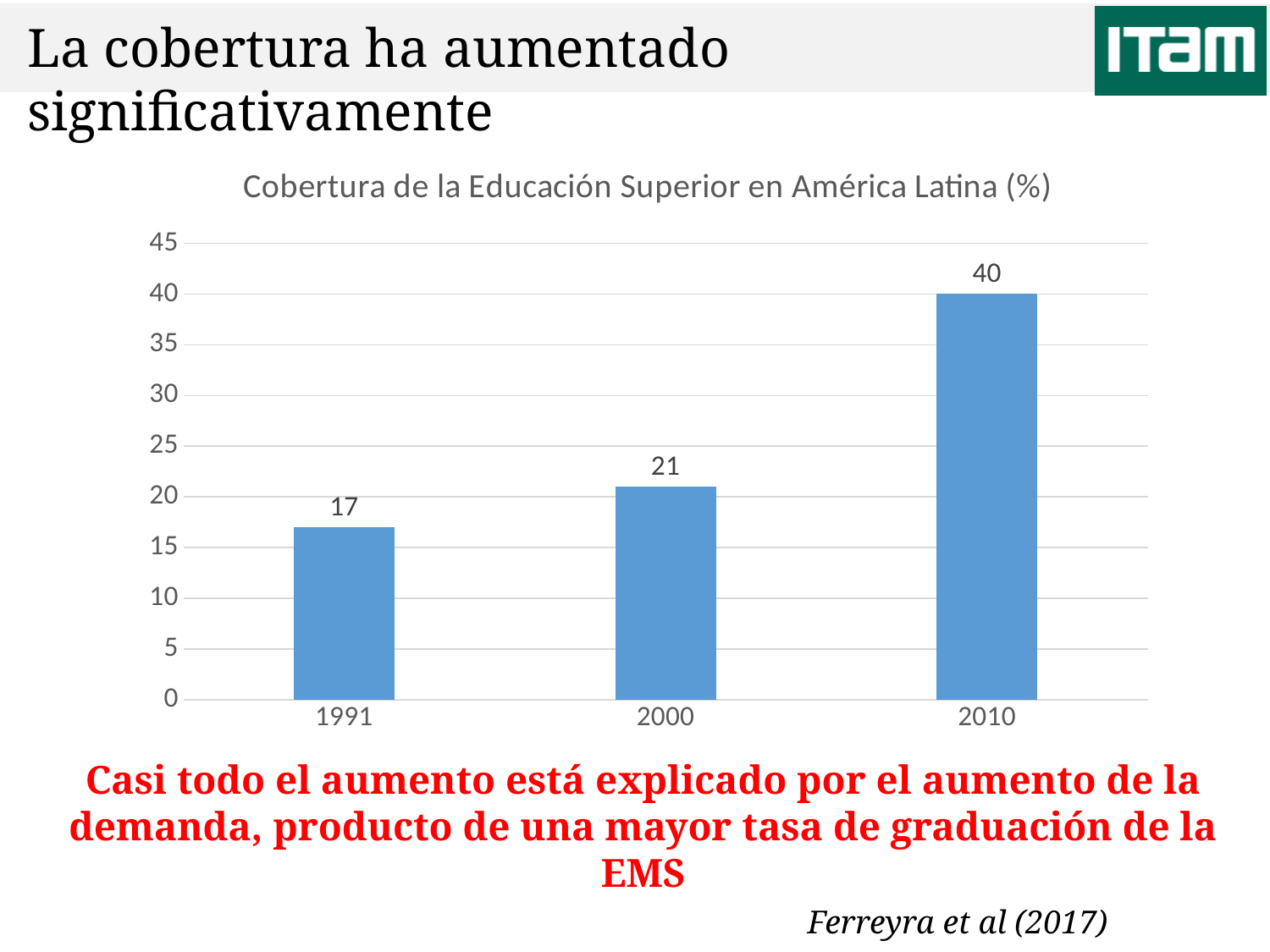
What is the title of the chart? Cobertura de la Educación Superior en América Latina (%) What is the difference between the values for 2000 and 1991? 4 What kind of chart is shown on the slide? bar chart Is the value for 2010 greater or less than 35? greater What is the value for 1991? 17 Which is larger, the value for 2000 or the value for 2010? 2010 What is the difference between the values for 2010 and 1991? 23 What is the value for 2000? 21 Which year has the highest value? 2010 How many years are shown on the x axis? 3 What is the value for 2010? 40 Which year has the lowest value? 1991